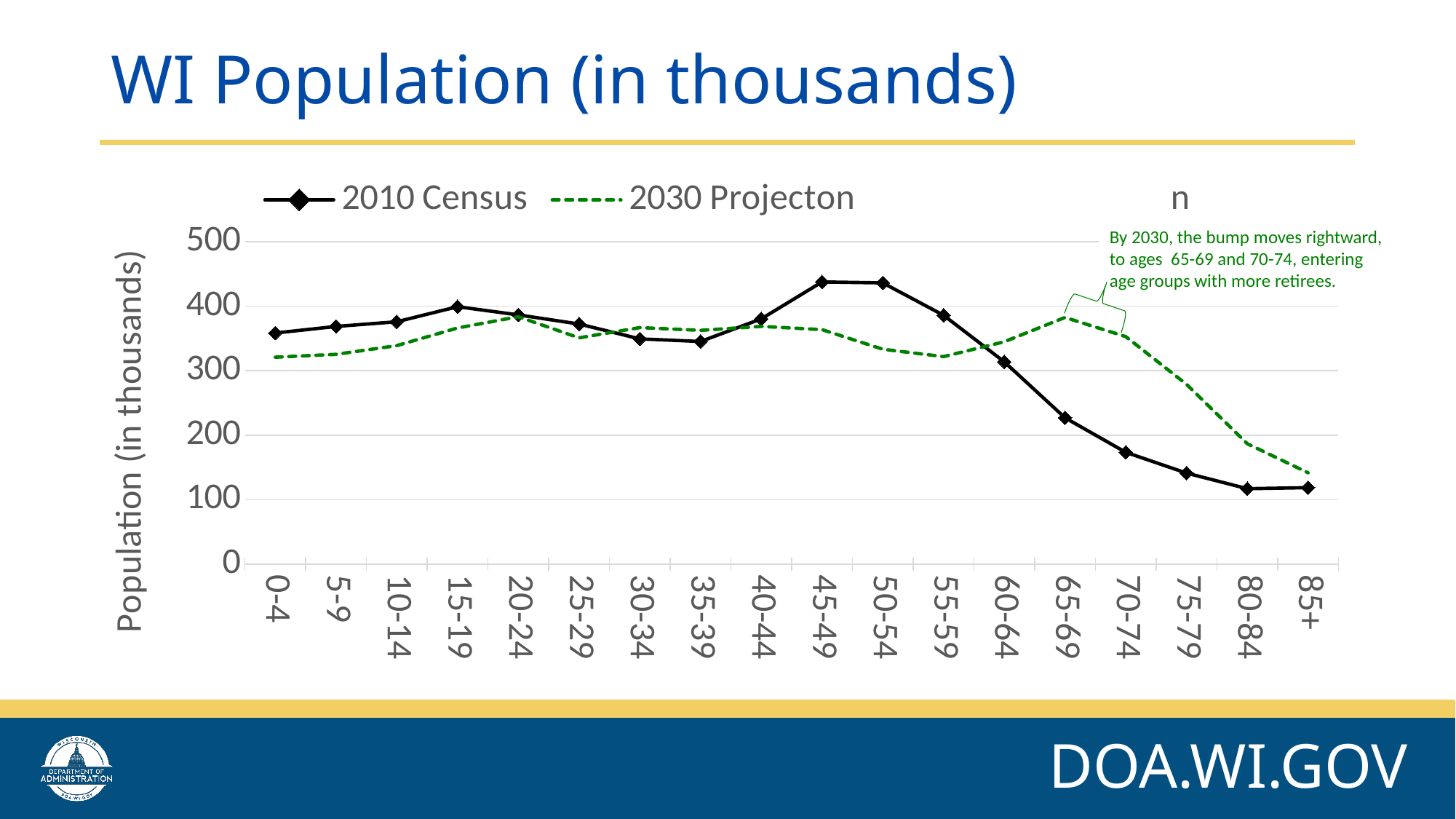
For the 65-69 age group, which series has the larger value, 2010 Census or 2030 Projection? 2030 Projection Is the 2010 Census value for the 80-84 age group greater or less than 200? less Does the 2010 Census line rise or fall from the 50-54 age group to the 80-84 age group? fall How many series does the legend list? 2 What is the label on the vertical axis? Population (in thousands) Is the 2010 Census value for the 45-49 age group greater or less than 400? greater Is the 2030 Projection value for the 85+ age group greater or less than 200? less What kind of chart is shown on the slide? line chart Which age group has the lowest value for the 2030 Projection series? 85+ For the 45-49 age group, which series has the larger value, 2010 Census or 2030 Projection? 2010 Census How many age groups are shown on the x axis? 18